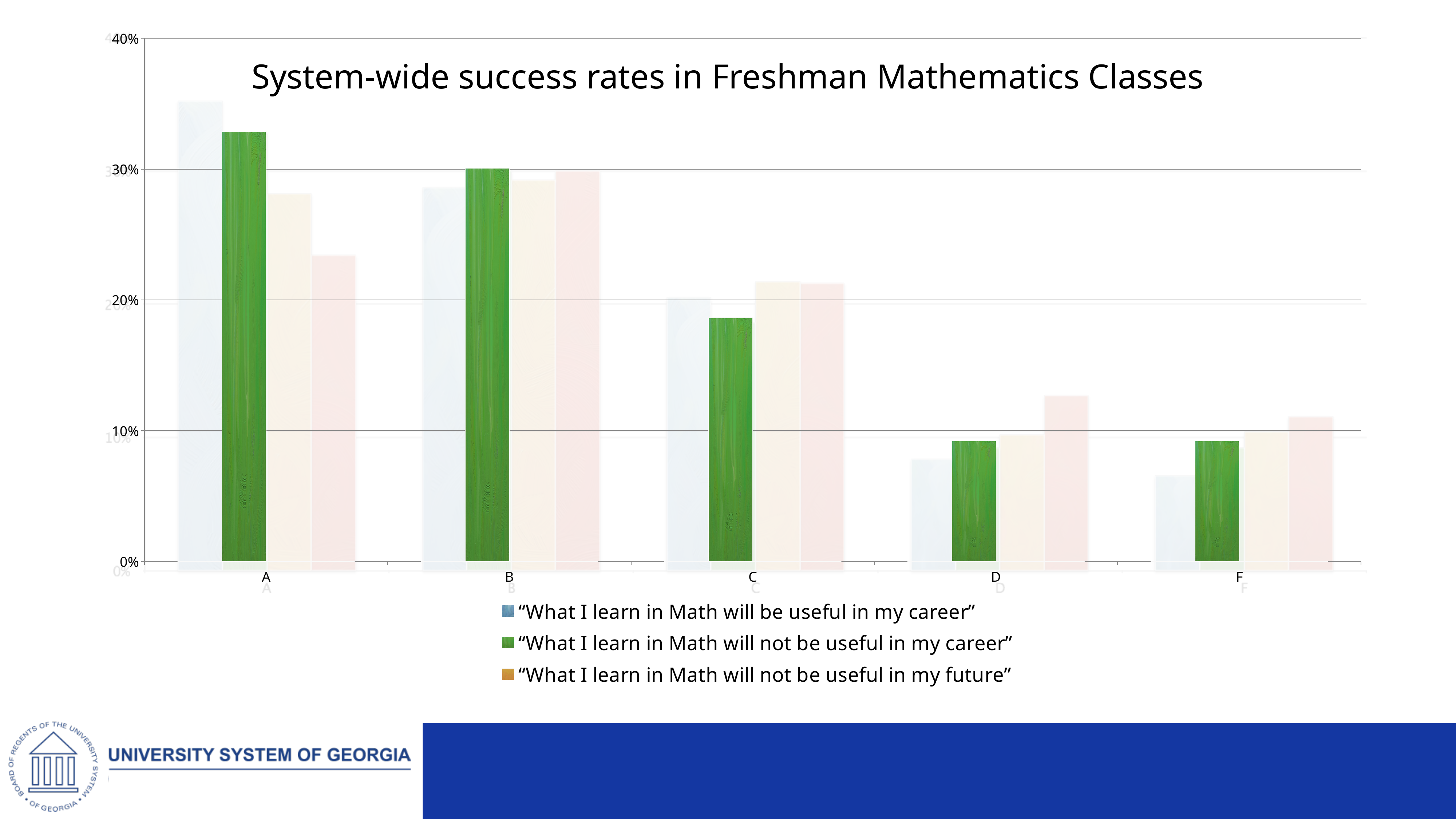
How many categories are shown on the x axis? 5 Is the value for A in the series "What I learn in Math will not be useful in my career" greater or less than 30%? greater Do the values for the series "What I learn in Math will not be useful in my career" rise or fall from A to F? fall Which category has the highest value for the series "What I learn in Math will not be useful in my career"? A Is the value for D in the series "What I learn in Math will not be useful in my career" greater or less than 10%? less What kind of chart is shown on the slide? bar chart What is the title of the chart? System-wide success rates in Freshman Mathematics Classes Is the value for B in the series "What I learn in Math will not be useful in my career" greater or less than 20%? greater How many series does the legend list? 3 In the series "What I learn in Math will not be useful in my career", which is larger, the value for A or the value for C? A Which legend entry is shown in green? "What I learn in Math will not be useful in my career"